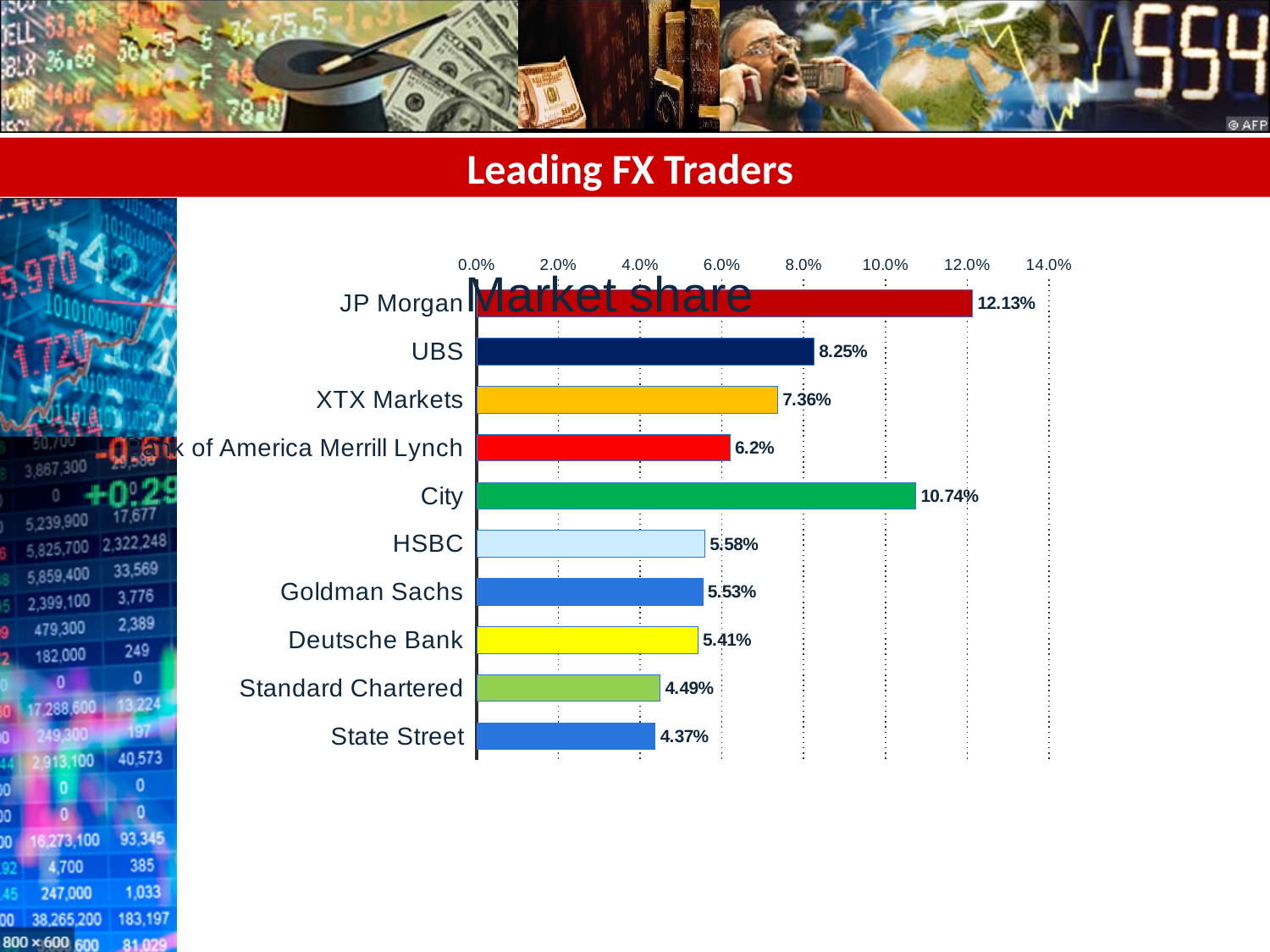
What is the difference between the market share of City and HSBC? 5.16% Is the value for City greater or less than 10.0%? greater What is the title of the chart? Market share Which has a larger market share, UBS or XTX Markets? UBS What is the market share value shown for City? 10.74% Which category has the highest market share in the chart? JP Morgan What is the market share value shown for Standard Chartered? 4.49% How many categories (traders) are shown in the chart? 10 What is the market share value shown for JP Morgan? 12.13% What is the difference between the market share of JP Morgan and UBS? 3.88% What kind of chart is shown on the slide? Bar chart Which category has the lowest market share in the chart? State Street